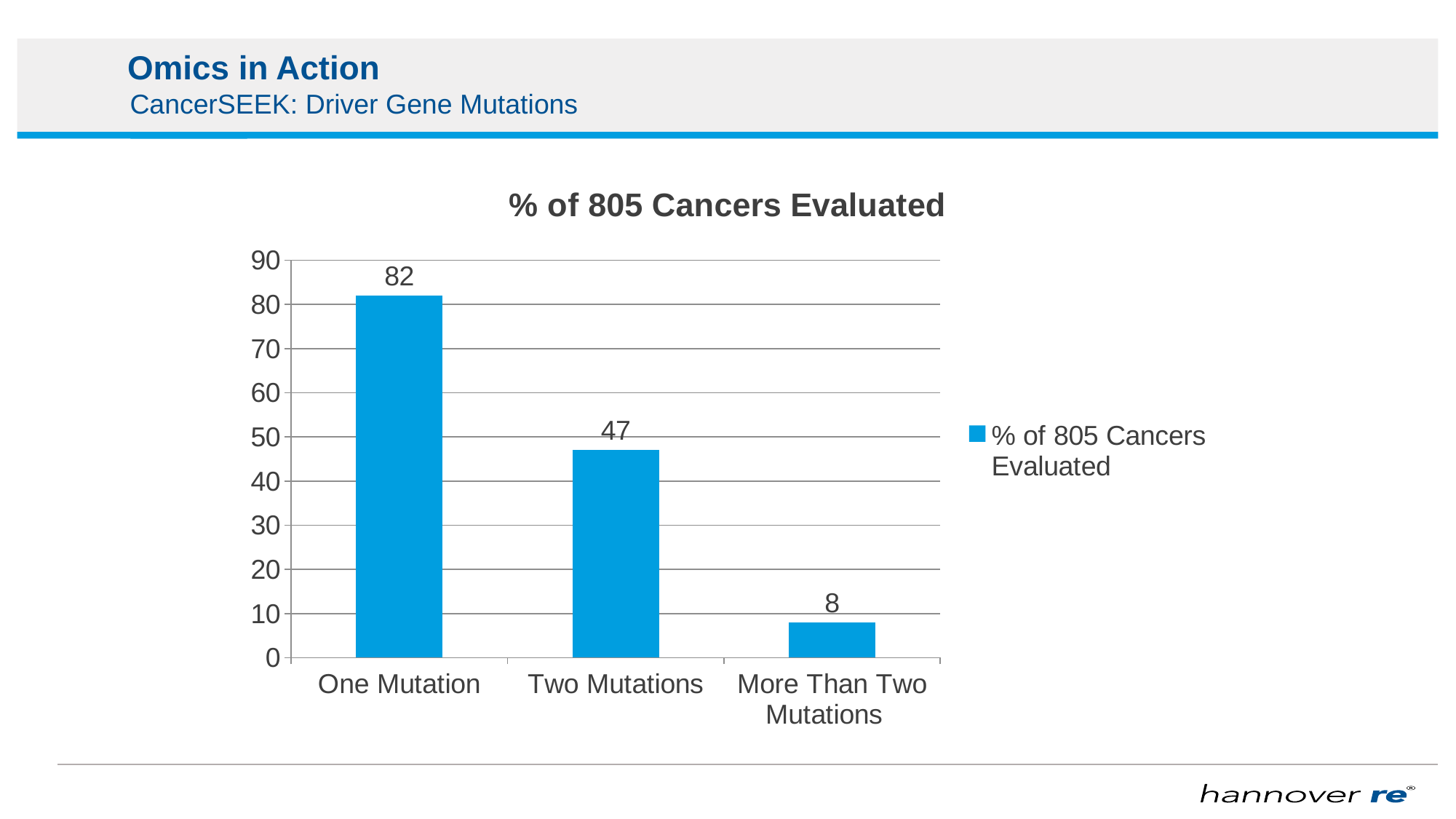
What is the value for More Than Two Mutations? 8 What is the difference between the values for One Mutation and Two Mutations? 35 Which category has the highest value? One Mutation Which is larger, the value for Two Mutations or the value for More Than Two Mutations? Two Mutations What kind of chart is shown on the slide? bar chart How many categories are shown on the x axis? 3 What is the value for One Mutation? 82 What is the difference between the values for Two Mutations and More Than Two Mutations? 39 What is the value for Two Mutations? 47 What is the title of the chart? % of 805 Cancers Evaluated Is the value for Two Mutations greater or less than 50? less Which category has the lowest value? More Than Two Mutations